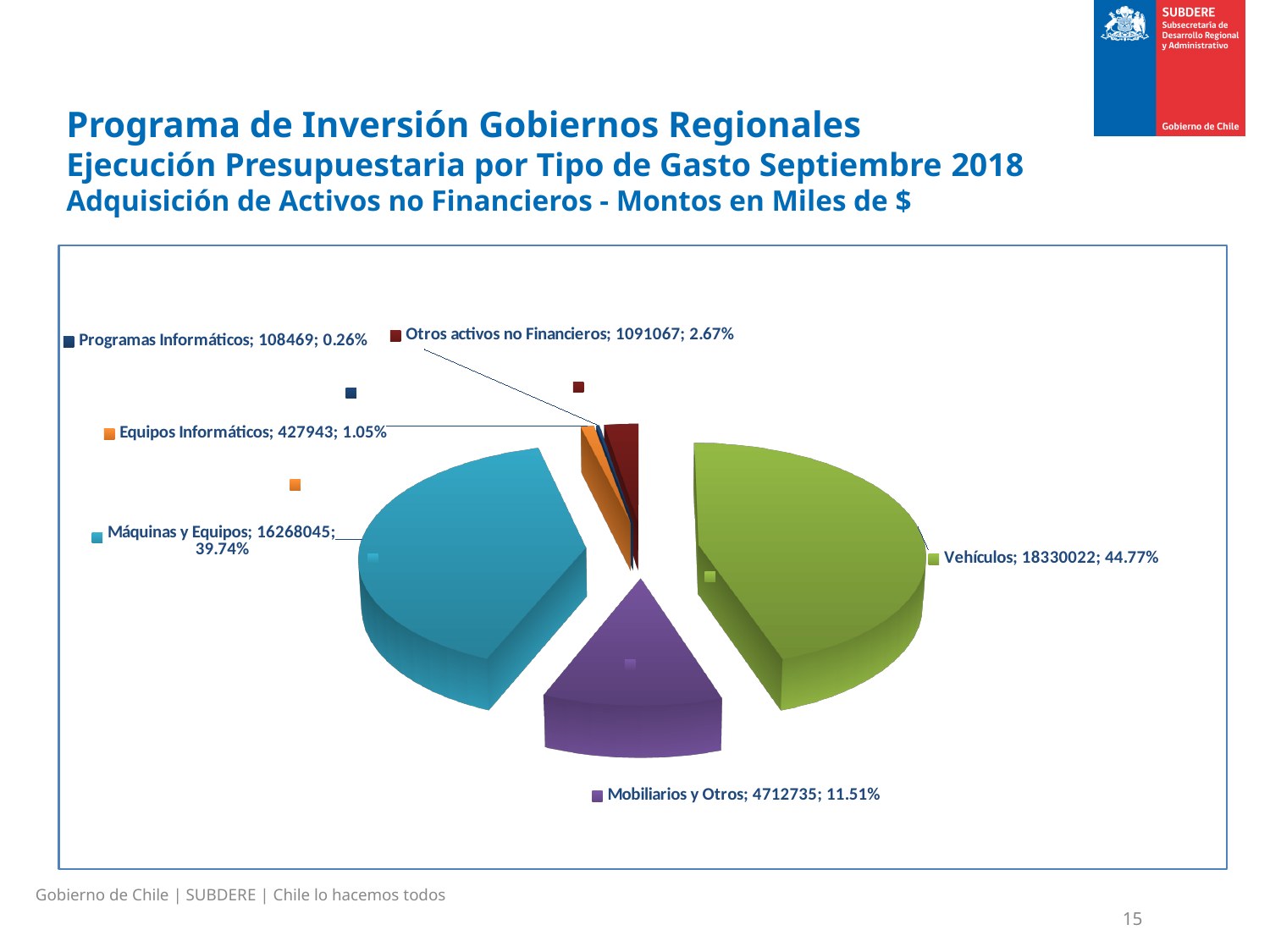
Which is larger, the value for Mobiliarios y Otros or the value for Otros activos no Financieros? Mobiliarios y Otros What is the third line of the slide title, describing the chart's subject and units? Adquisición de Activos no Financieros - Montos en Miles de $ What percentage share does Equipos Informáticos have? 1.05% What percentage share does Otros activos no Financieros have? 2.67% What is the value shown for Máquinas y Equipos? 16268045 How many categories (slices) does the pie chart show? 6 What is the value shown for Vehículos? 18330022 Which category has the smallest share of the pie? Programas Informáticos What is the value shown for Mobiliarios y Otros? 4712735 What is the difference between the values for Vehículos and Máquinas y Equipos? 2061977 Which category has the largest share of the pie? Vehículos What type of chart is shown on the slide? Pie chart